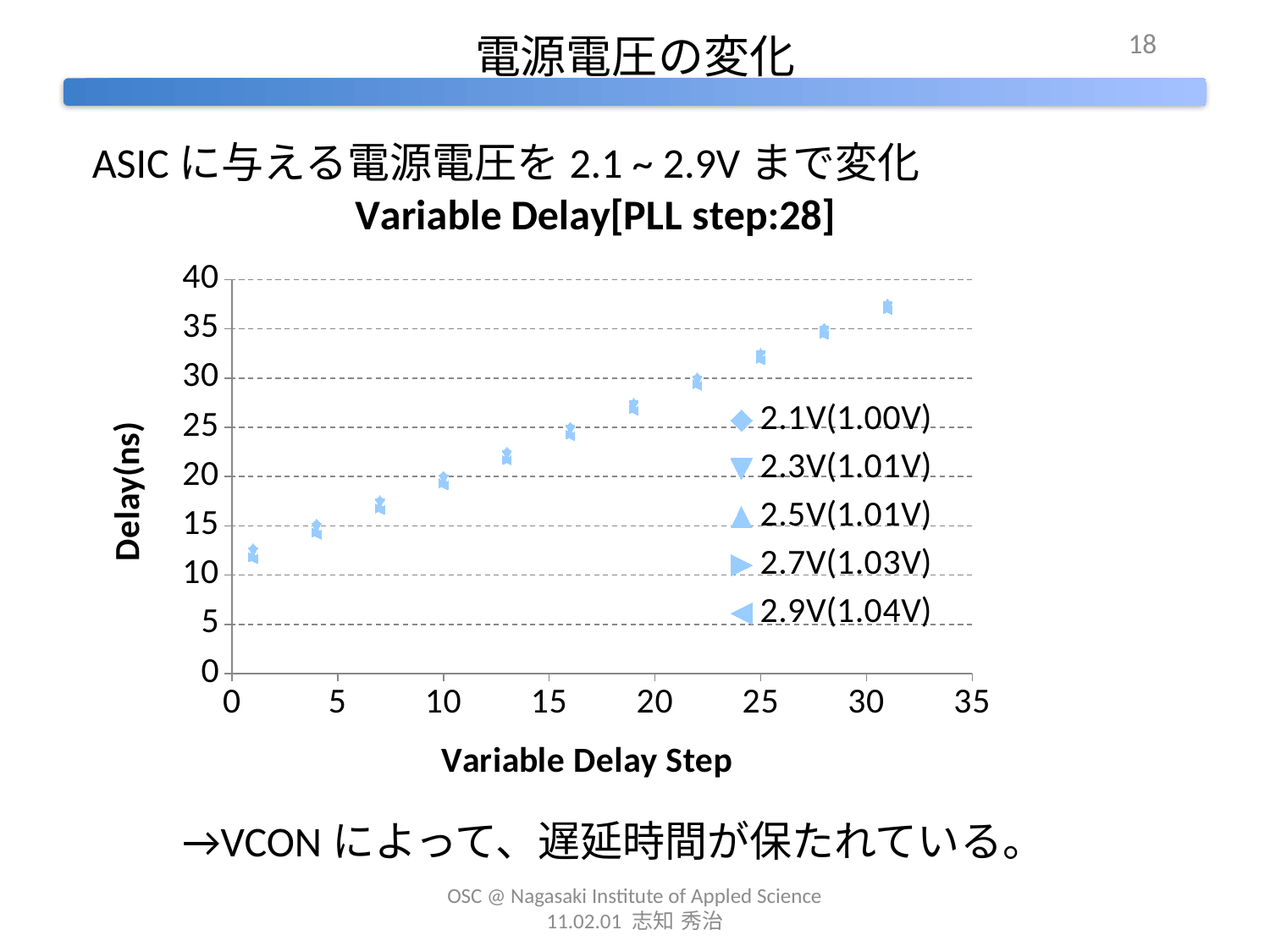
Is the delay at Variable Delay Step 19 greater or less than 25? greater Does the delay rise or fall as the Variable Delay Step increases? rise What is the label of the y axis? Delay(ns) Is the delay at Variable Delay Step 13 greater or less than 25? less Is the delay at Variable Delay Step 1 greater or less than 10? greater What is the title of the chart? Variable Delay[PLL step:28] How many series does the legend list? 5 What kind of chart is shown on the slide? scatter chart Which Variable Delay Step has the highest delay? 31